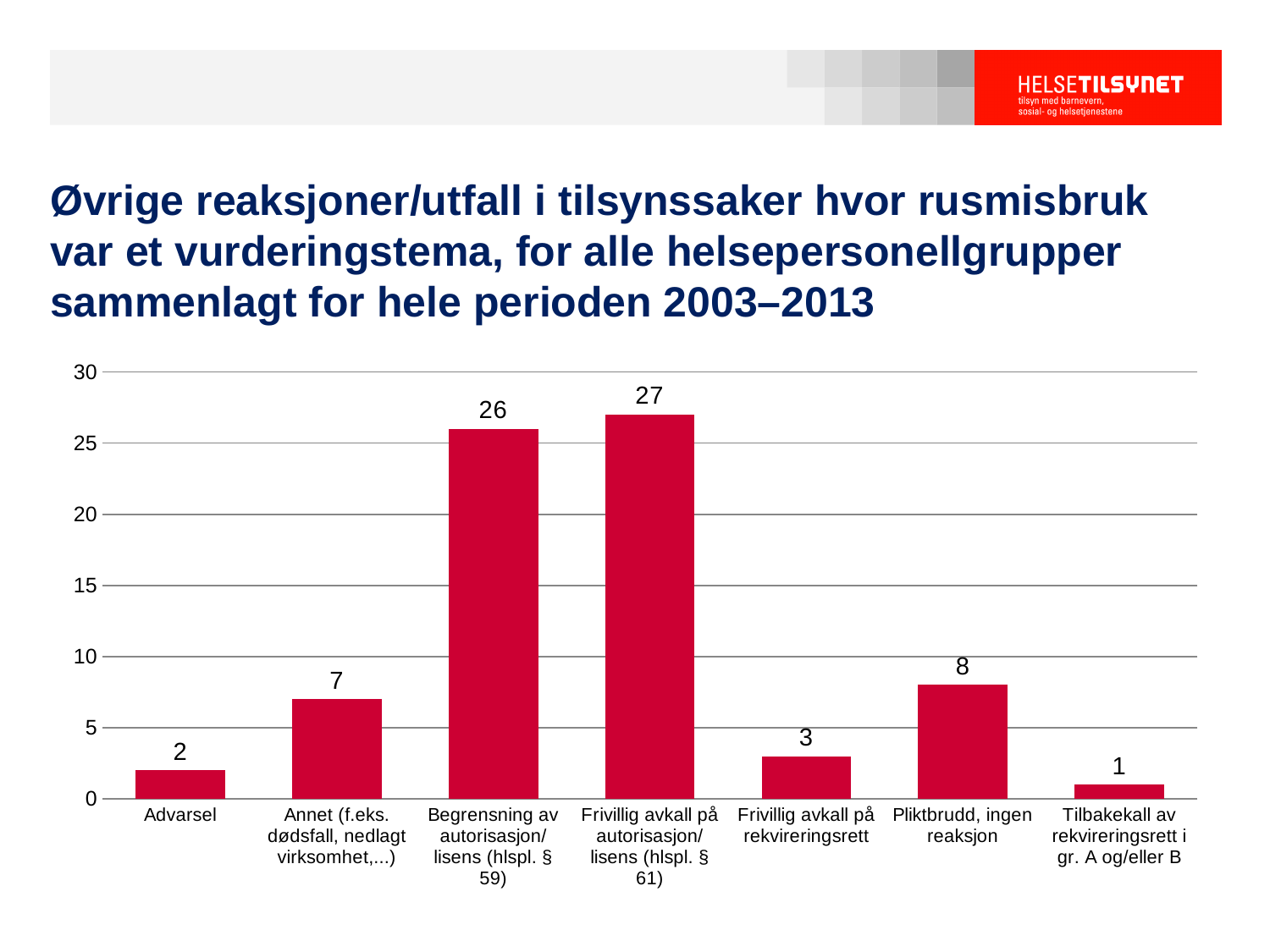
Which category has the lowest value? Tilbakekall av rekvireringsrett i gr. A og/eller B What is the difference between the values for Begrensning av autorisasjon/lisens (hlspl. § 59) and Annet (f.eks. dødsfall, nedlagt virksomhet,...)? 19 How many categories are shown on the x axis? 7 What is the value for Frivillig avkall på rekvireringsrett? 3 What is the total of the values for Advarsel and Tilbakekall av rekvireringsrett i gr. A og/eller B? 3 What is the value for Pliktbrudd, ingen reaksjon? 8 What is the value for Advarsel? 2 Which is larger, the value for Pliktbrudd, ingen reaksjon or the value for Annet (f.eks. dødsfall, nedlagt virksomhet,...)? Pliktbrudd, ingen reaksjon Which category has the highest value? Frivillig avkall på autorisasjon/lisens (hlspl. § 61) What is the highest value shown on the y axis? 30 Is the value for Begrensning av autorisasjon/lisens (hlspl. § 59) greater or less than 25? greater What kind of chart is shown on the slide? bar chart